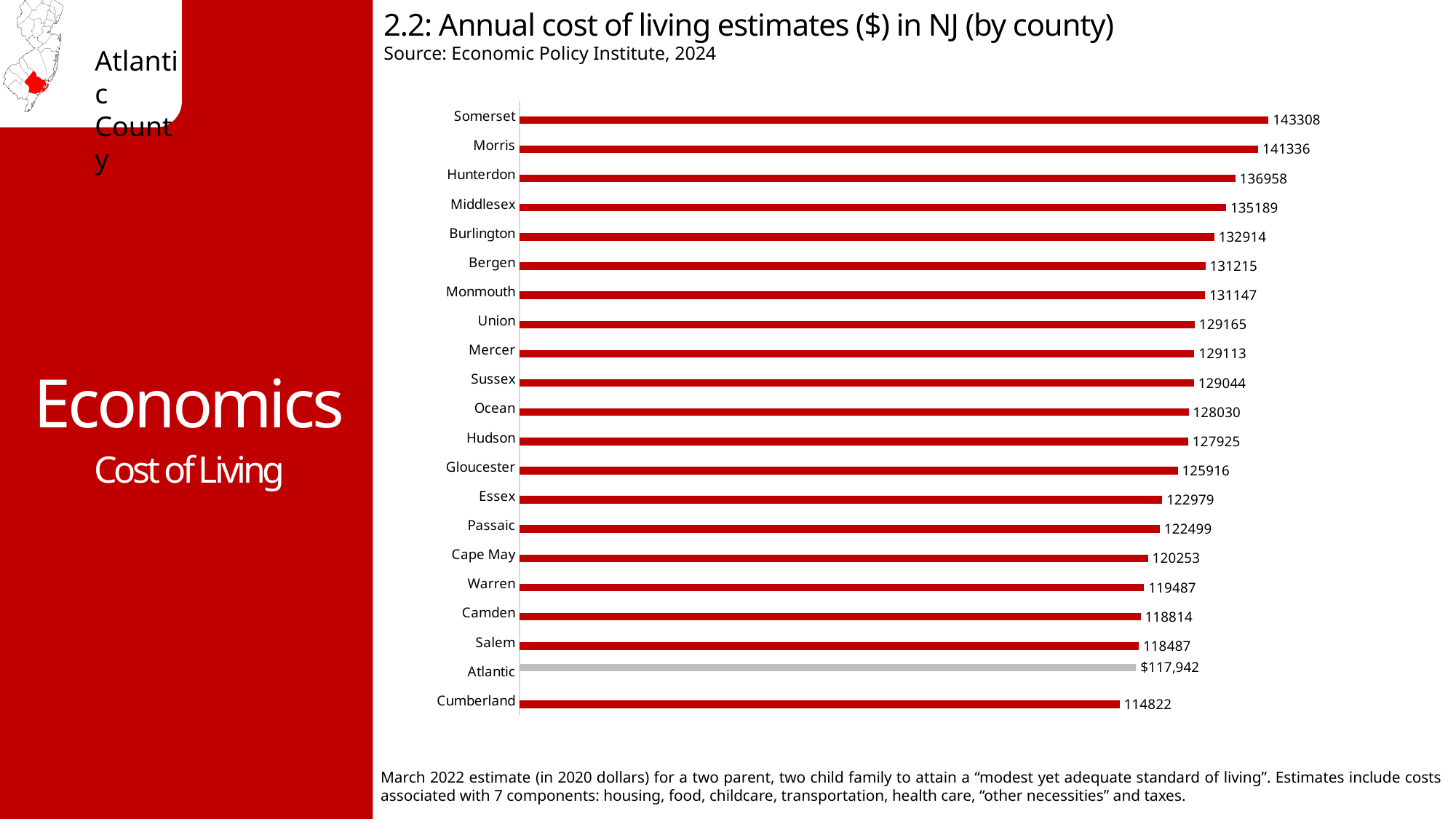
Which county has a higher cost of living estimate, Hunterdon or Bergen? Hunterdon What is the difference between the cost of living estimates for Somerset and Cumberland? 28486 How many counties are shown in the chart? 21 What is the annual cost of living estimate for Atlantic county? $117,942 What is the annual cost of living estimate for Somerset county? 143308 What is the annual cost of living estimate for Gloucester county? 125916 What type of chart is used to show the annual cost of living estimates? Bar chart Which county has the lowest annual cost of living estimate? Cumberland What is the difference between the cost of living estimates for Somerset and Morris? 1972 Which county has the highest annual cost of living estimate? Somerset Which county's bar is shown in a different colour (grey) from the others? Atlantic Which county has a higher cost of living estimate, Camden or Cape May? Cape May